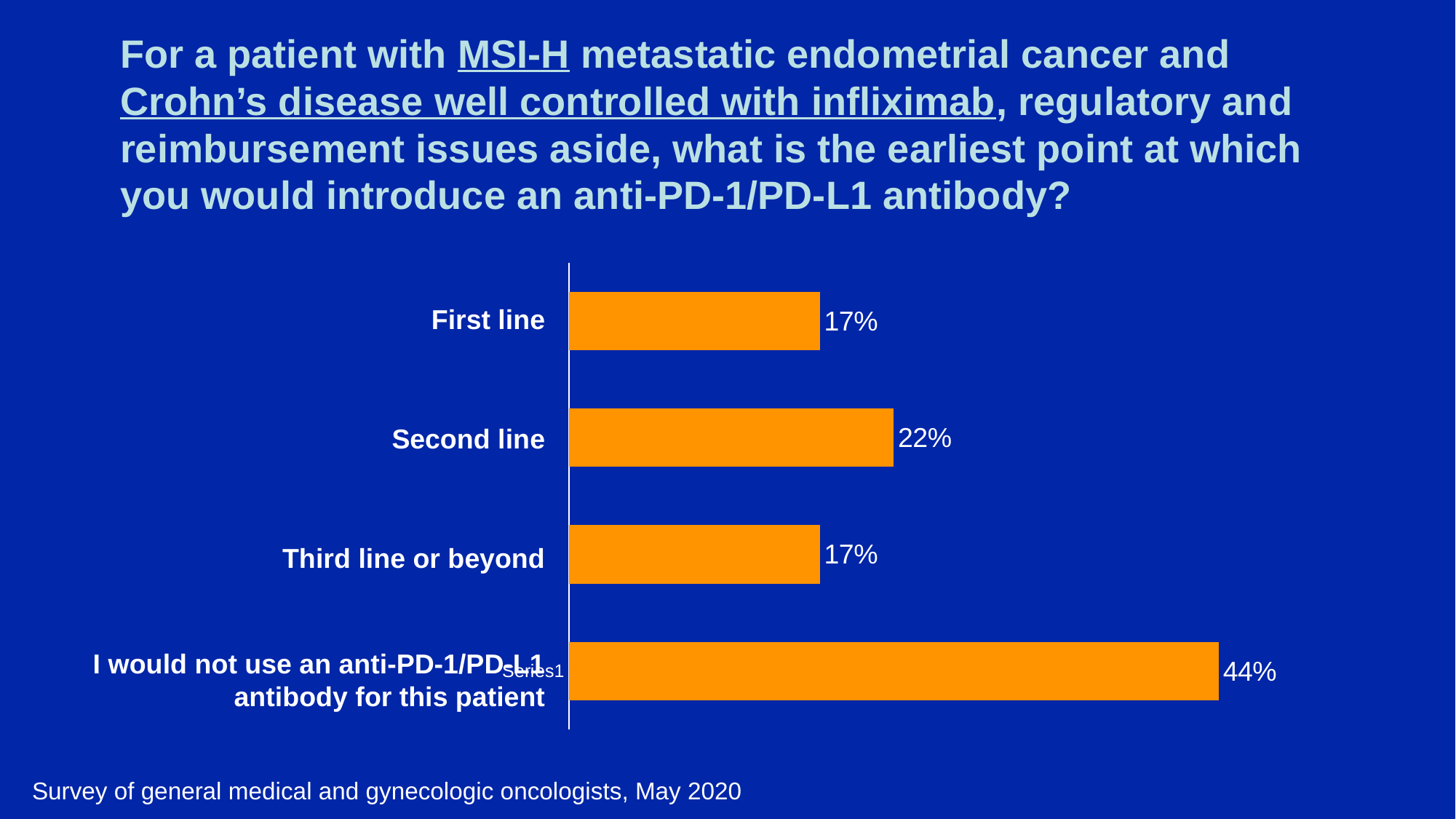
What percentage of respondents chose "Third line or beyond"? 17% What colour are the bars in the chart? Orange Which response option received the highest percentage? I would not use an anti-PD-1/PD-L1 antibody for this patient Do "First line" and "Third line or beyond" have the same percentage? Yes, both 17% What type of chart is shown on the slide? Bar chart What percentage of respondents chose "Second line"? 22% Which received a larger share of responses, "Second line" or "Third line or beyond"? Second line What percentage of respondents said they would not use an anti-PD-1/PD-L1 antibody for this patient? 44% How many response options are shown in the chart? 4 What is the difference in percentage points between "I would not use an anti-PD-1/PD-L1 antibody for this patient" and "Second line"? 22 percentage points What percentage of respondents chose "First line"? 17% What is the difference in percentage points between "Second line" and "First line"? 5 percentage points